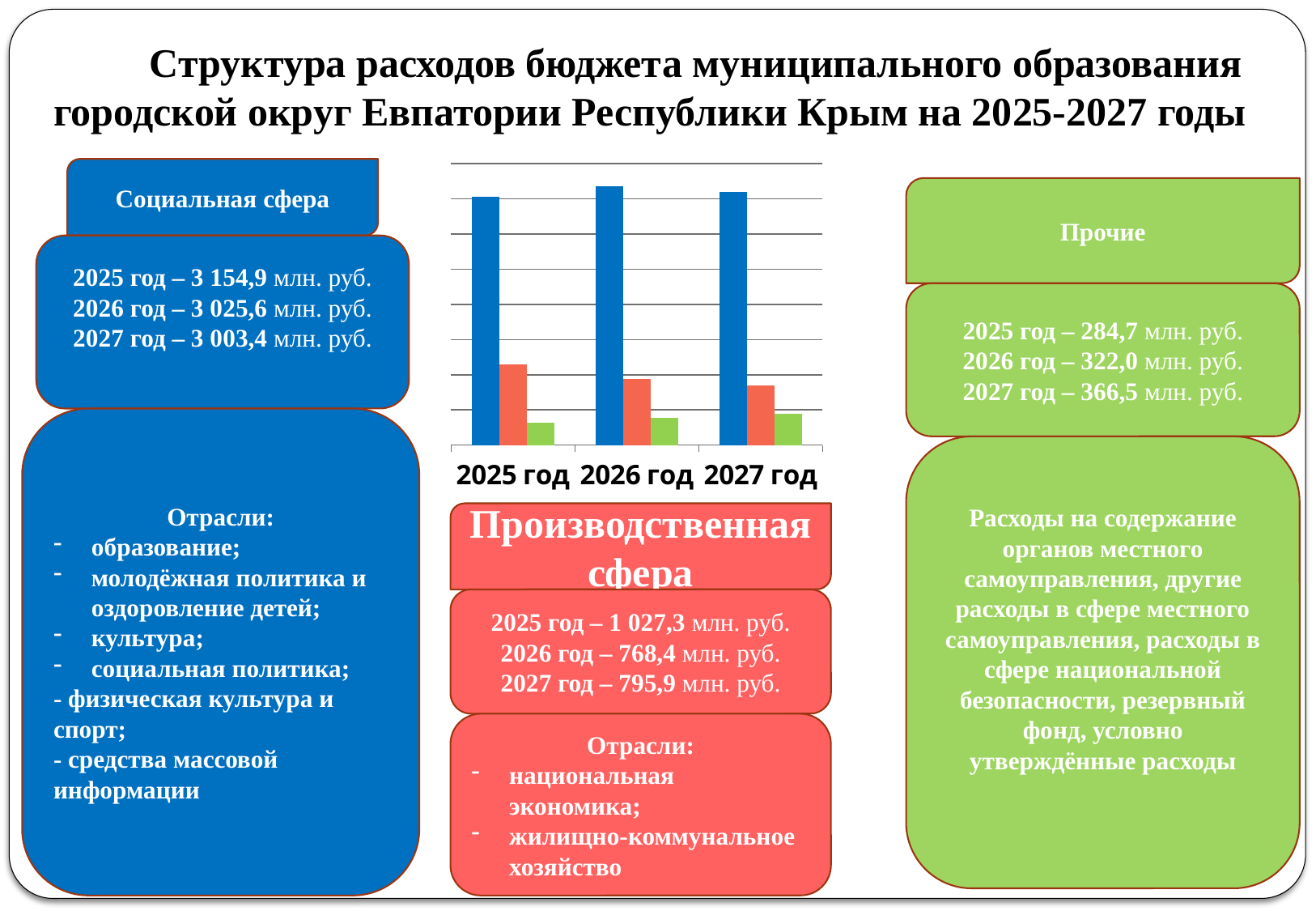
According to the slide, what is the Социальная сфера expenditure for 2025 год? 3 154,9 млн. руб. How many bars are plotted for each year on the chart? 3 Which coloured bar is the tallest in every year group on the chart? blue According to the slide, what is the Прочие expenditure for 2027 год? 366,5 млн. руб. Is the green bar taller for 2027 год or for 2025 год? 2027 год Do the green bars rise or fall from 2025 год to 2027 год? rise What kind of chart is shown on the slide? bar chart By how much does the Прочие expenditure for 2027 год exceed that for 2025 год, according to the slide? 81,8 млн. руб. How many categories are shown on the x axis of the chart? 3 According to the slide, what is the Производственная сфера expenditure for 2026 год? 768,4 млн. руб. Which coloured bar is the shortest in every year group on the chart? green Is the red bar taller for 2025 год or for 2026 год? 2025 год